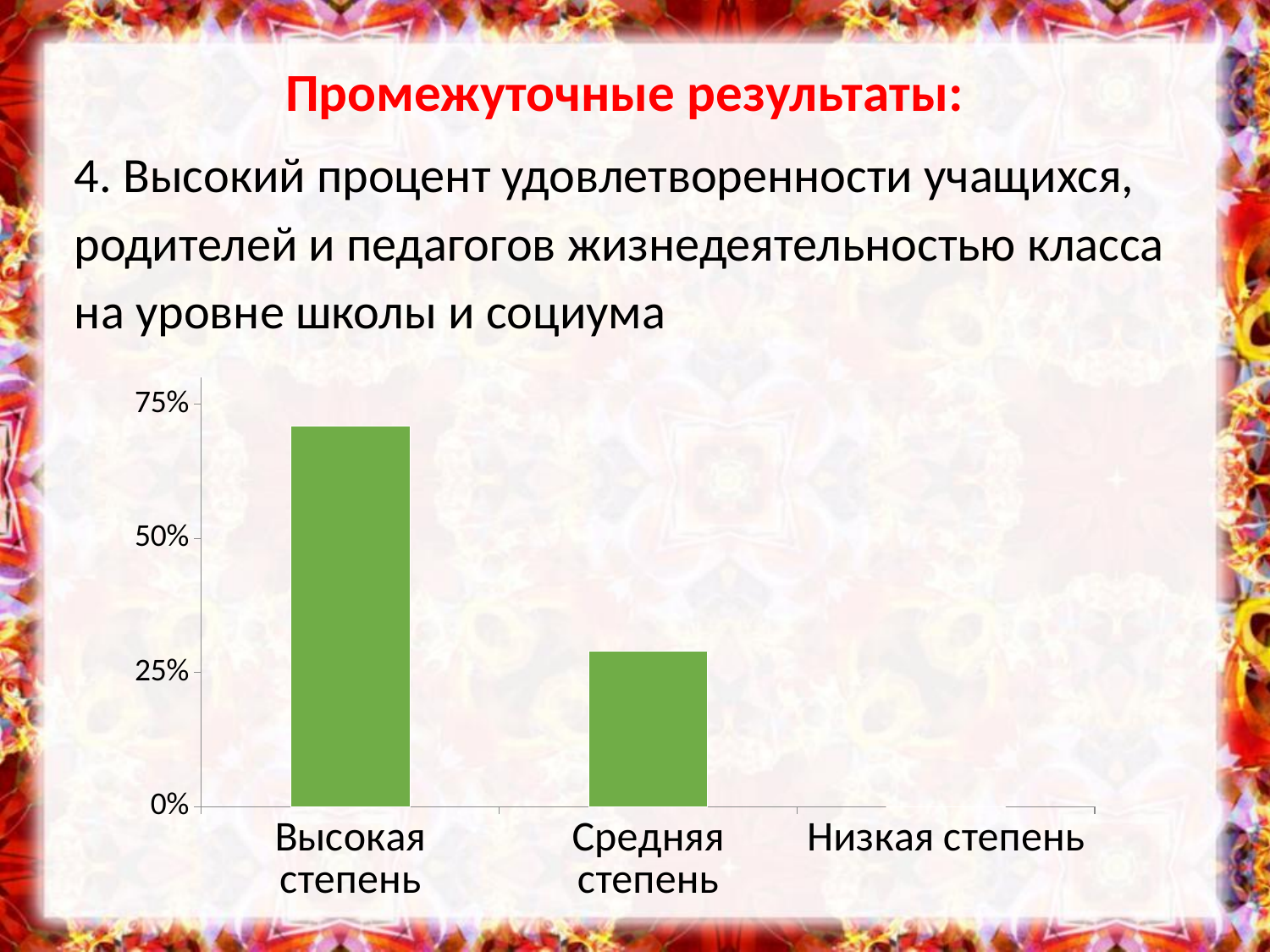
What kind of chart is shown on the slide? bar chart Is the value for Средняя степень greater or less than 50%? less Is the value for Высокая степень greater or less than 50%? greater Is the value for Средняя степень greater or less than 25%? greater What is the highest value labelled on the vertical axis of the chart? 75% How many categories are shown on the x axis of the chart? 3 Which category has the highest value in the chart? Высокая степень Do the values rise or fall from left to right along the x axis? fall What colour are the bars in the chart? green Which category has the lowest value in the chart? Низкая степень Which is larger, the value for Высокая степень or the value for Средняя степень? Высокая степень